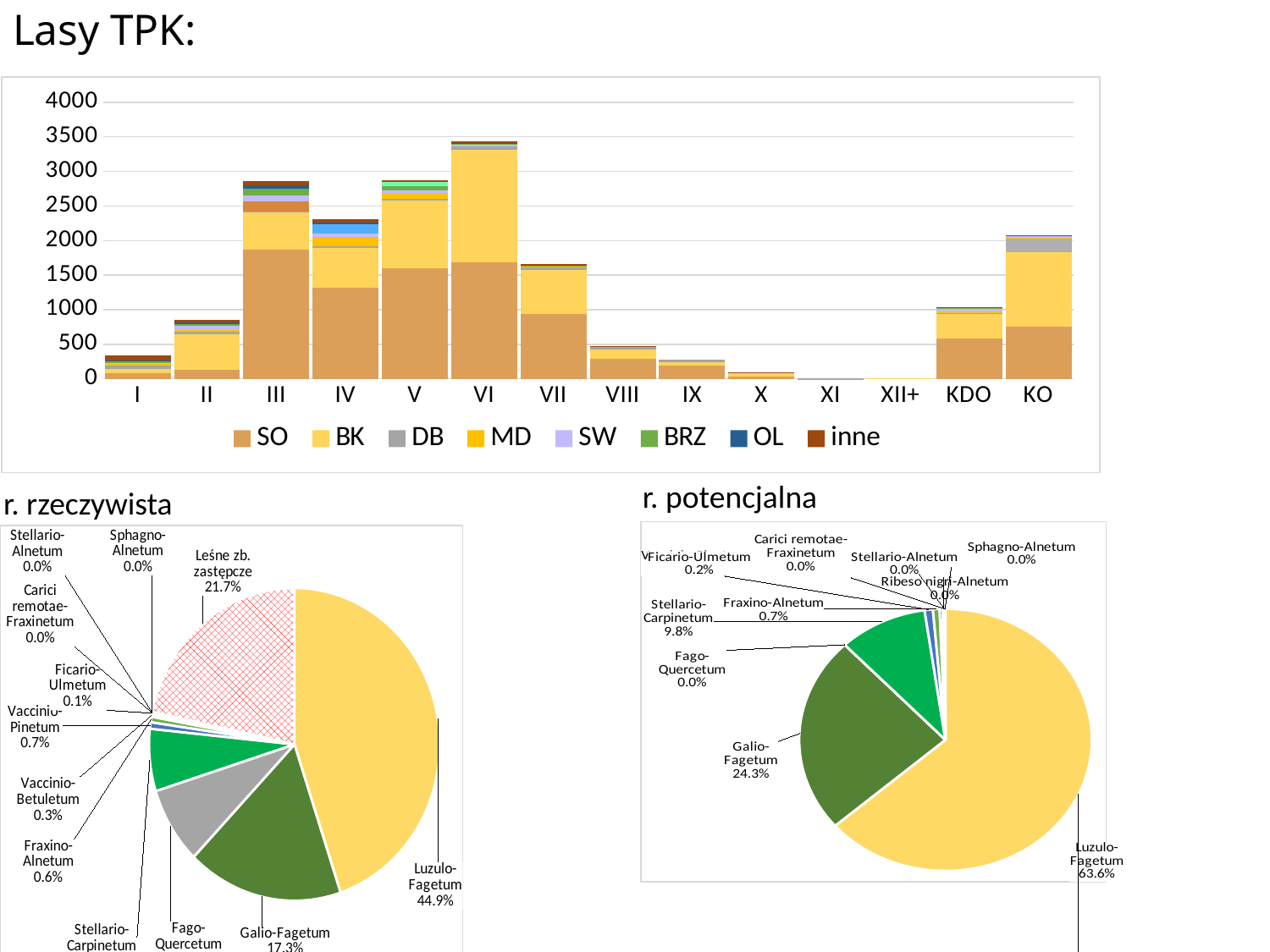
What is the difference between the Luzulo-Fagetum share in the 'r. potencjalna' pie chart and in the 'r. rzeczywista' pie chart? 18.7% In the top bar chart, do the stacked totals rise or fall from category VI to category XI? fall In the 'r. rzeczywista' pie chart, what share does Luzulo-Fagetum have? 44.9% In the top bar chart, is the total for category XI greater or less than 500? less In the top bar chart, which category has the tallest stacked bar? VI How many categories are shown on the x axis of the top bar chart? 14 What kind of chart is the top chart on the slide? bar chart In the 'r. potencjalna' pie chart, what share does Galio-Fagetum have? 24.3% In the top bar chart, is the total for category III greater or less than 2500? greater How many series does the legend of the top bar chart list? 8 In the top bar chart, is the total for category VI greater or less than 3000? greater In the 'r. rzeczywista' pie chart, what share does Leśne zb. zastępcze have? 21.7%